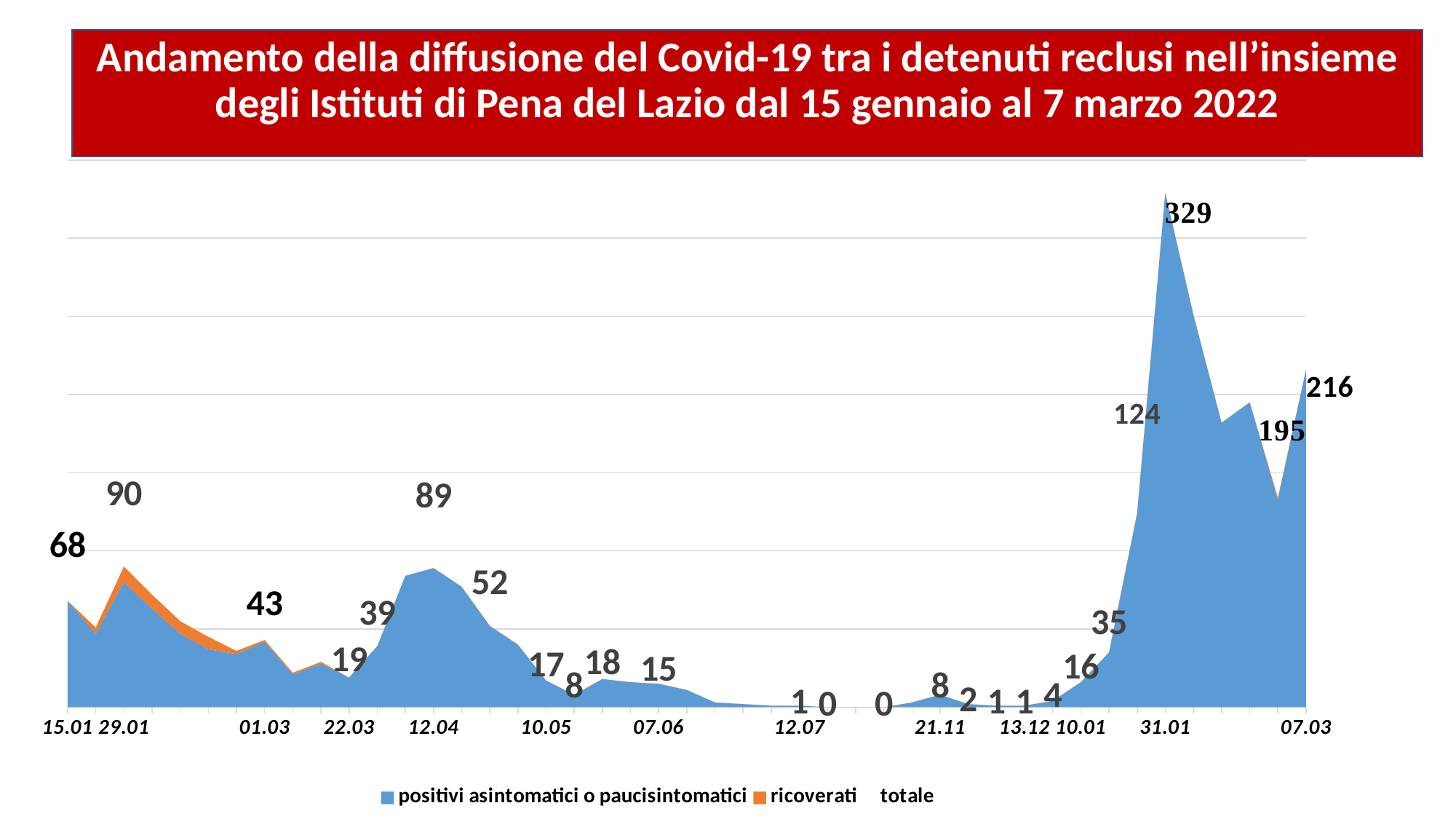
Which is larger, the value labelled at 29.01 or the value labelled at 12.04? 29.01 What is the value labelled at the first date, 15.01? 68 What is the value labelled at 29.01? 90 How many series does the legend list? 3 What is the value labelled at 12.04? 89 What kind of chart is shown on the slide? Area chart What is the difference between the peak value of 329 and the final value of 216? 113 What is the lowest value labelled on the chart? 0 Which colour represents the 'ricoverati' series in the legend? Orange What is the value labelled at the last date, 07.03? 216 Do the values rise or fall between 10.01 and 31.01? Rise What is the highest value labelled on the chart? 329